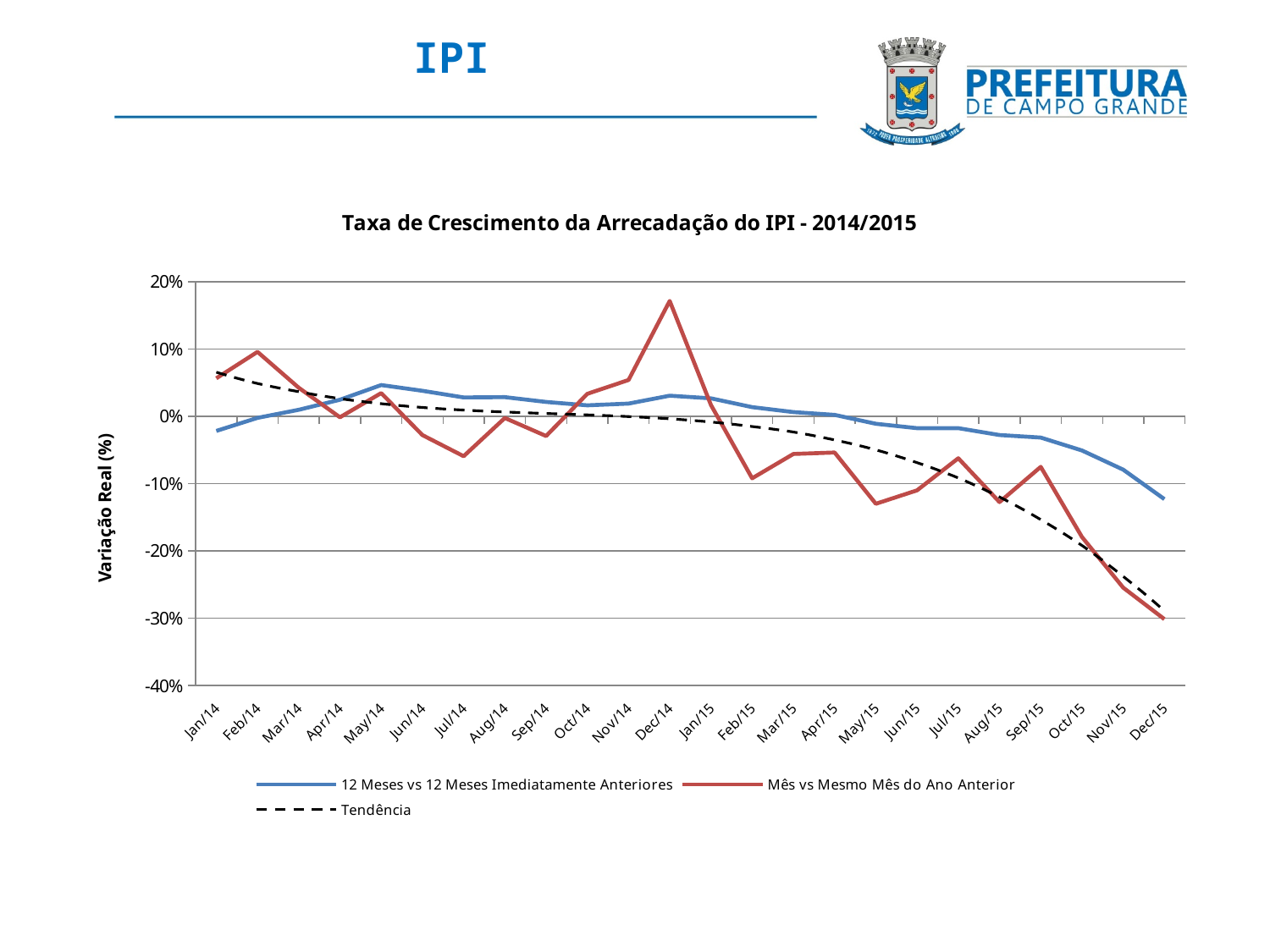
Is the value of '12 Meses vs 12 Meses Imediatamente Anteriores' in Dec/15 greater or less than -10%? less What kind of chart is shown on the slide? line chart In which month does the 'Mês vs Mesmo Mês do Ano Anterior' series reach its highest value? Dec/14 In which month does the '12 Meses vs 12 Meses Imediatamente Anteriores' series reach its lowest value? Dec/15 Is the value of 'Mês vs Mesmo Mês do Ano Anterior' in Dec/15 greater or less than -20%? less What is the title of the chart? Taxa de Crescimento da Arrecadação do IPI - 2014/2015 How many series does the legend list? 3 Is the value of 'Mês vs Mesmo Mês do Ano Anterior' in Dec/14 greater or less than 10%? greater Which series is drawn as a dashed black line? Tendência In Dec/15, which series has the larger value: '12 Meses vs 12 Meses Imediatamente Anteriores' or 'Mês vs Mesmo Mês do Ano Anterior'? 12 Meses vs 12 Meses Imediatamente Anteriores In which month does the 'Mês vs Mesmo Mês do Ano Anterior' series reach its lowest value? Dec/15 How many months are plotted along the x axis? 24